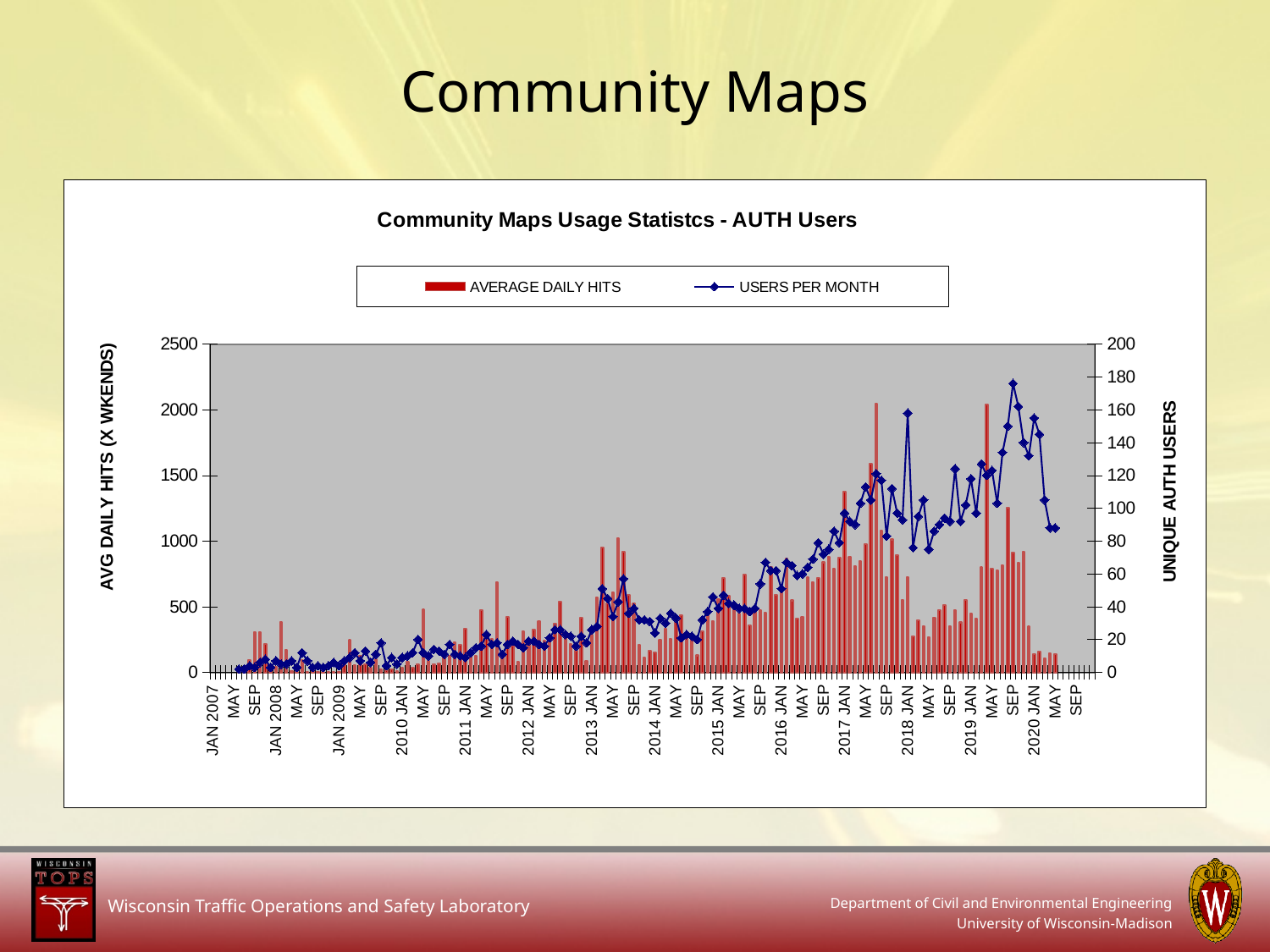
Is the AVERAGE DAILY HITS value at SEP 2017 greater or less than 1500? less What is the maximum value shown on the right-hand vertical axis (UNIQUE AUTH USERS)? 200 What is the label of the right-hand vertical axis? UNIQUE AUTH USERS What is the maximum value shown on the left-hand vertical axis (AVG DAILY HITS)? 2500 What kind of chart is shown on the slide? Combined bar and line chart What is the title of the chart on the slide? Community Maps Usage Statistcs - AUTH Users Which series is drawn as red bars in the chart? AVERAGE DAILY HITS How many series does the chart's legend list? 2 In which year does the USERS PER MONTH line reach its highest point? 2019 Is the USERS PER MONTH value at JAN 2009 greater or less than 20? less Does the USERS PER MONTH line generally rise or fall from 2007 to 2019? rise Is the USERS PER MONTH value at SEP 2019 greater or less than 160? greater